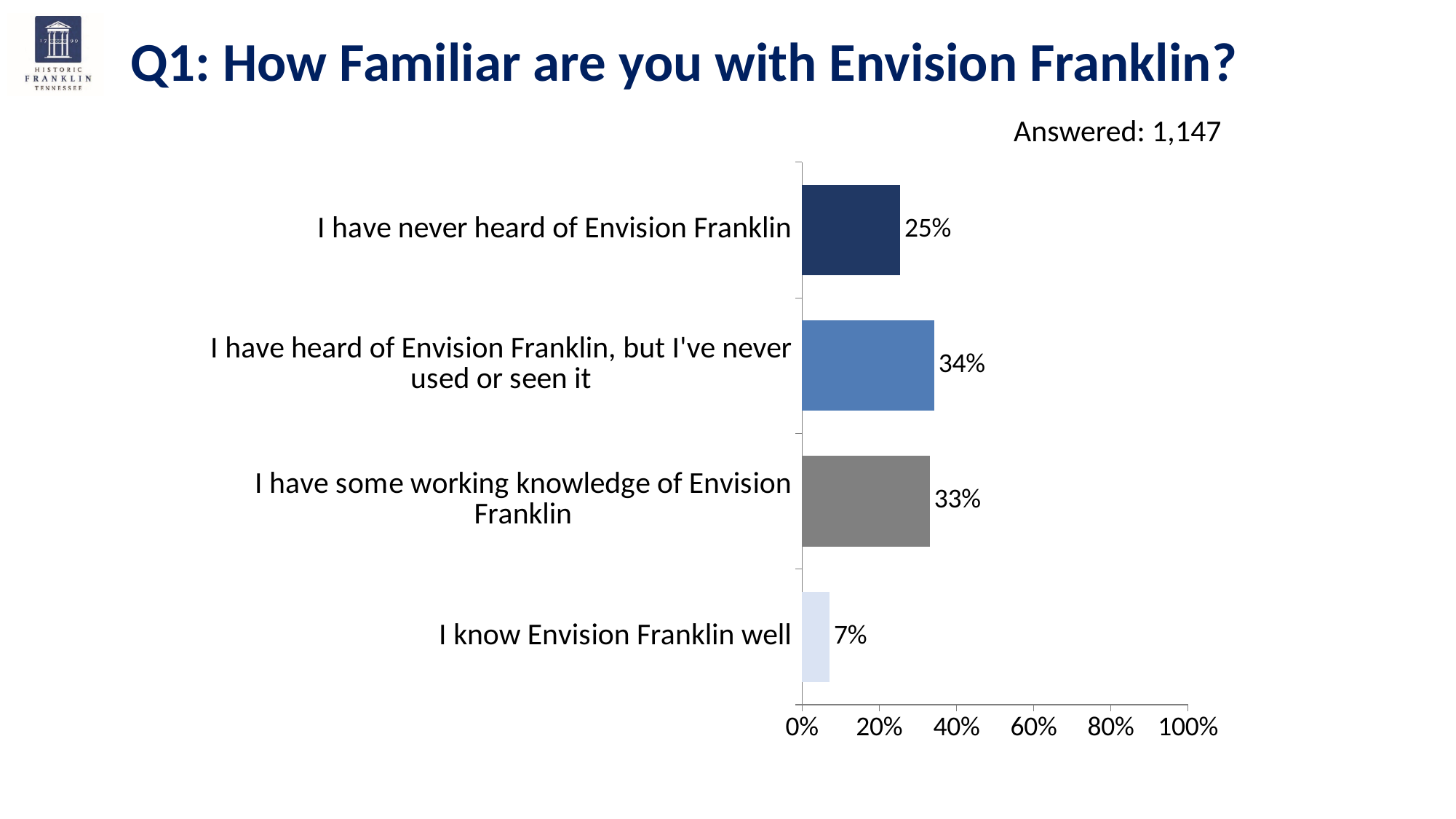
Which is larger: the percentage for 'I have never heard of Envision Franklin' or for 'I have some working knowledge of Envision Franklin'? I have some working knowledge of Envision Franklin Is the value for 'I have never heard of Envision Franklin' greater or less than 20%? greater What is the difference in percentage points between 'I have heard of Envision Franklin, but I've never used or seen it' and 'I have some working knowledge of Envision Franklin'? 1 What percentage of respondents said they have heard of Envision Franklin but have never used or seen it? 34% Which response category has the lowest percentage? I know Envision Franklin well How many people answered the question according to the slide? 1,147 What kind of chart is shown on the slide? Bar chart What percentage of respondents said they have some working knowledge of Envision Franklin? 33% What is the difference in percentage points between 'I have never heard of Envision Franklin' and 'I know Envision Franklin well'? 18 What percentage of respondents said they have never heard of Envision Franklin? 25% How many response categories are shown in the chart? 4 What percentage of respondents said they know Envision Franklin well? 7%